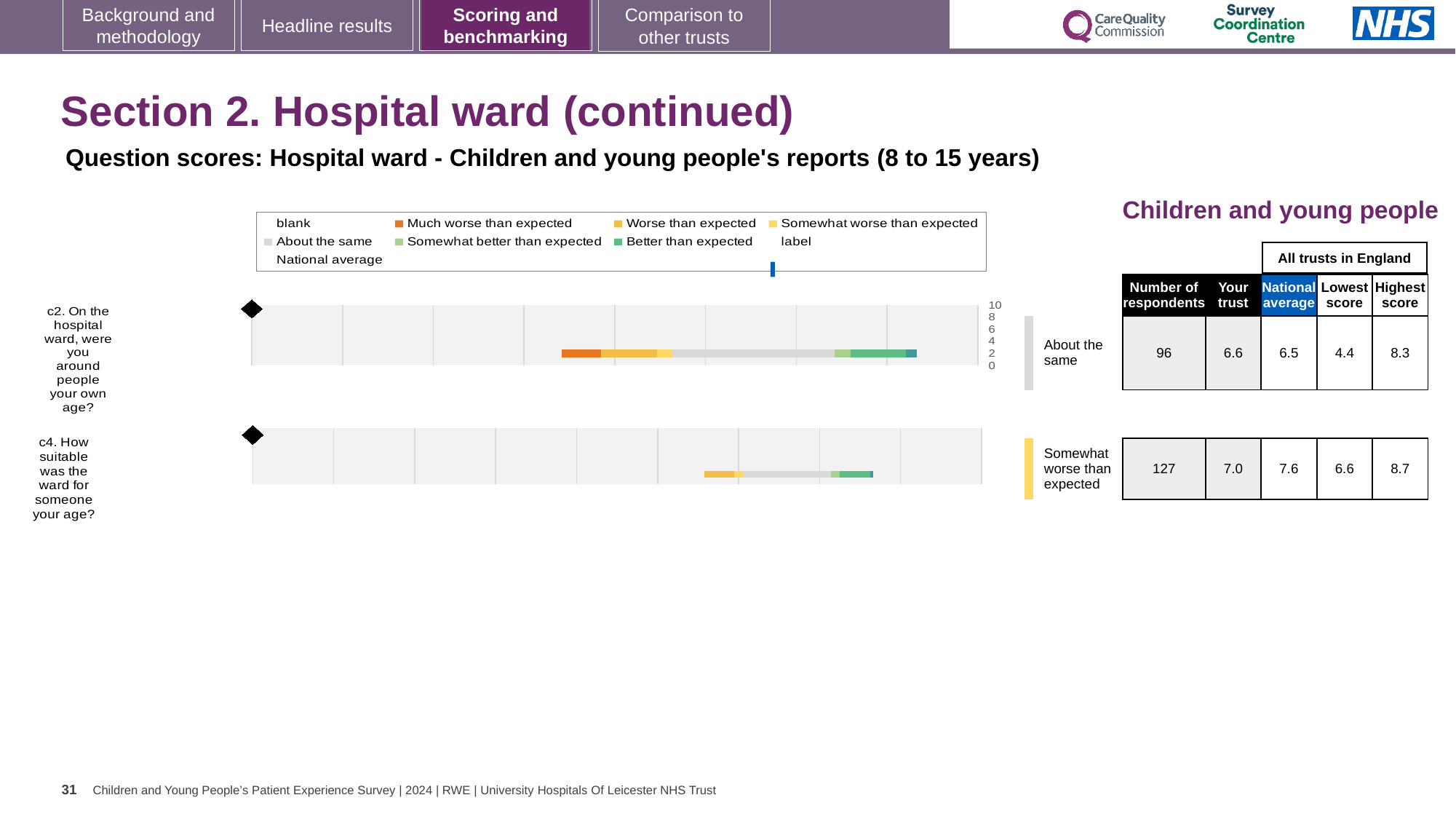
What is the difference between the highest score and the lowest score across all trusts in England for question c2? 3.9 How many questions (categories) are plotted on the slide's chart? 2 What is the national average score for question c4? 7.6 What is the highest score across all trusts in England for question c4? 8.7 Which question has the larger 'Your trust' score, c2 or c4? c4 How many entries does the chart legend list? 9 What kind of chart is used to show the question scores for c2 and c4? bar chart How many respondents answered question c2? 96 Which benchmark category is shown for question c4 (How suitable was the ward for someone your age?)? Somewhat worse than expected Which benchmark category is shown for question c2 (On the hospital ward, were you around people your own age?)? About the same What is the 'Your trust' score for question c4? 7.0 What is the 'Your trust' score for question c2? 6.6